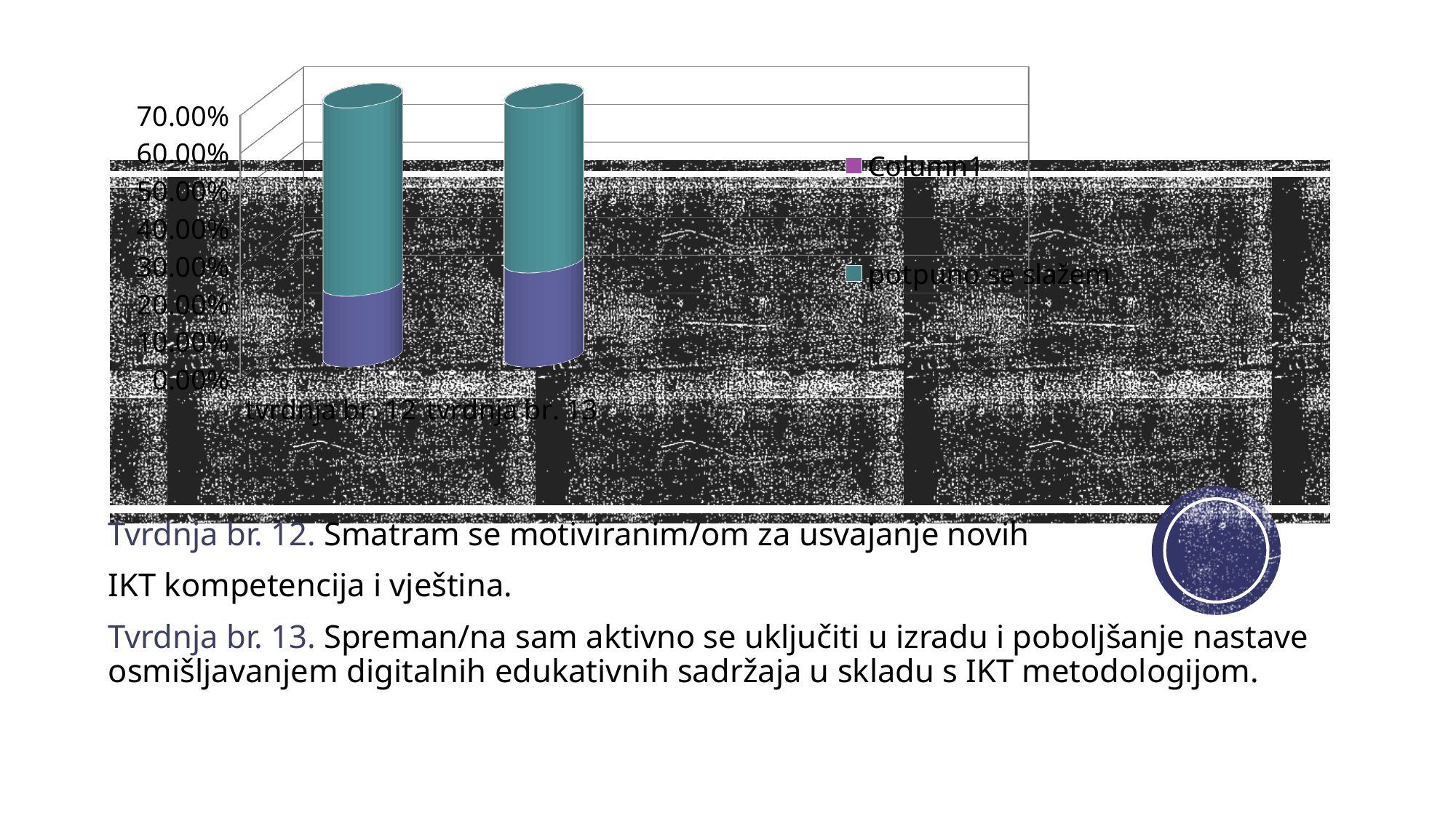
Which two categories are labelled on the x axis of the chart? tvrdnja br. 12 and tvrdnja br. 13 How many categories are shown on the x axis of the chart? 2 Is the potpuno se slažem segment larger for tvrdnja br. 12 or for tvrdnja br. 13? tvrdnja br. 12 Is the total height of the stacked bar for tvrdnja br. 12 greater or less than 50.00%? greater Is the total height of the stacked bar for tvrdnja br. 13 greater or less than 50.00%? greater What kind of chart is shown on the slide? bar chart